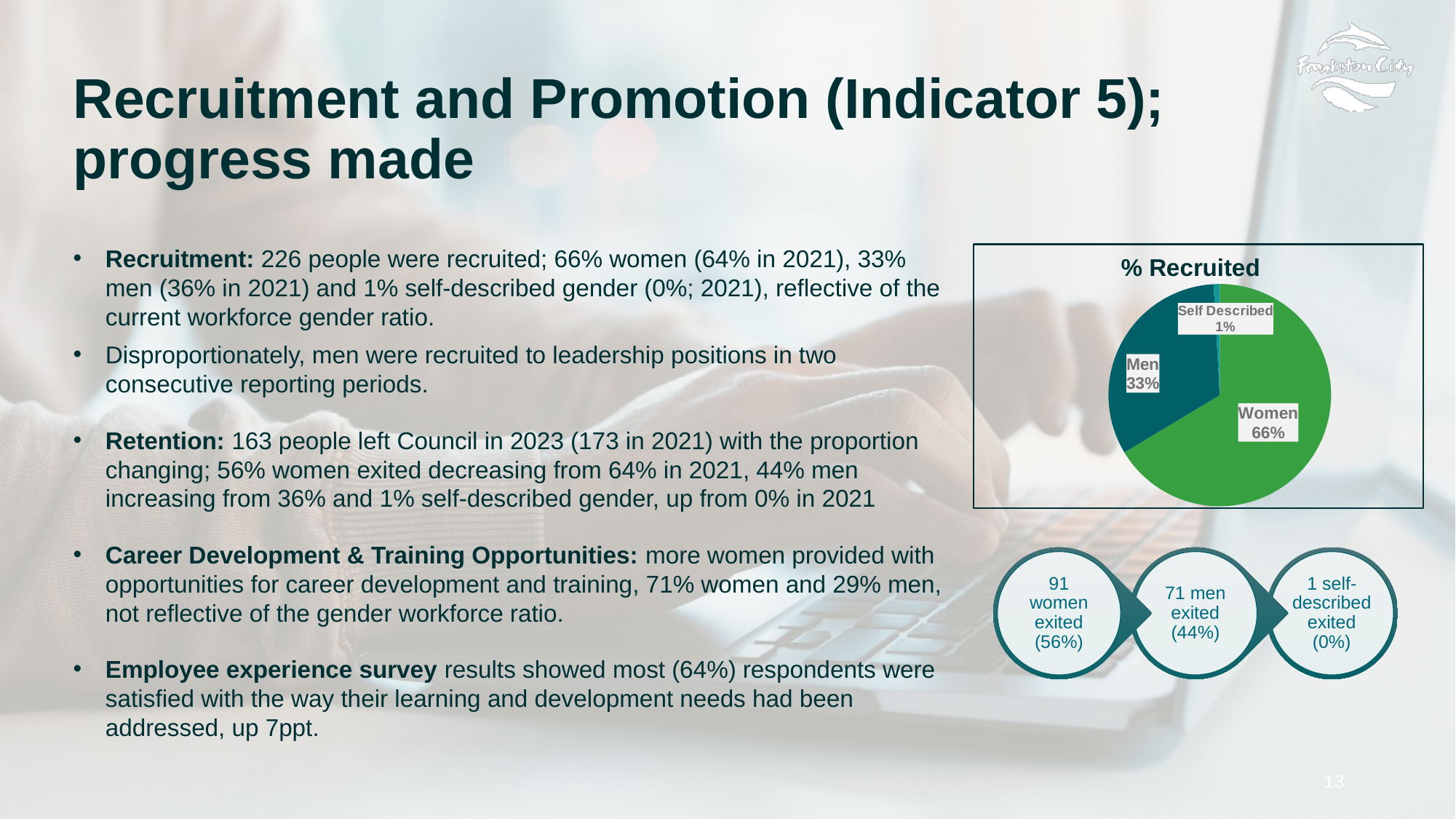
What type of chart is the "% Recruited" chart? pie chart In the "% Recruited" pie chart, what share is shown for Self Described? 1% In the "% Recruited" pie chart, what colour is the Women slice? green Which slice of the "% Recruited" pie chart is the smallest? Self Described In the "% Recruited" pie chart, what share is shown for Women? 66% In the "% Recruited" pie chart, how many percentage points larger is the Women slice than the Men slice? 33 In the "% Recruited" pie chart, which is larger: the Men slice or the Self Described slice? Men What is the title of the pie chart on the slide? % Recruited Which slice of the "% Recruited" pie chart is the largest? Women How many slices does the "% Recruited" pie chart have? 3 In the "% Recruited" pie chart, what share is shown for Men? 33%